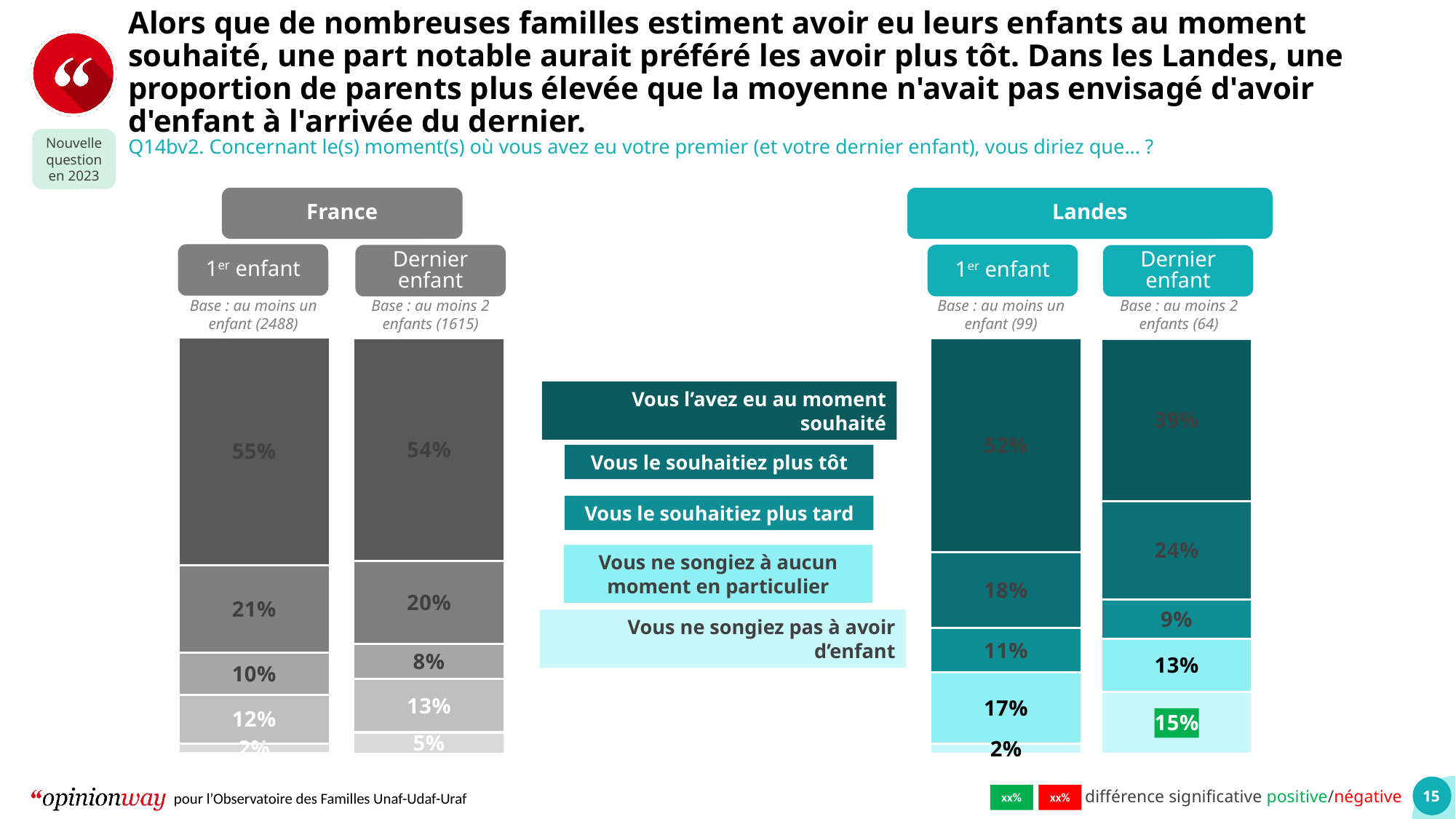
In the Landes chart, what is the value for "Vous le souhaitiez plus tôt" for the 1er enfant? 18% What is the base (number of respondents) for the Dernier enfant bar in the Landes chart? 64 What kind of chart is used on this slide? Stacked bar chart In the Landes chart, which segment of the Dernier enfant bar is highlighted in green as a significant positive difference, and what is its value? Vous ne songiez pas à avoir d'enfant, 15% What is the difference between the "Vous l'avez eu au moment souhaité" value for the 1er enfant in France (55%) and in the Landes (52%)? 3 points In the Landes chart, what percentage for the Dernier enfant corresponds to "Vous l'avez eu au moment souhaité"? 39% In the Landes chart, which response category has the highest value for the 1er enfant? Vous l'avez eu au moment souhaité In the France chart, what is the value for "Vous ne songiez pas à avoir d'enfant" for the Dernier enfant? 5% In the France chart, which response category has the lowest value for the 1er enfant? Vous ne songiez pas à avoir d'enfant In the France chart, what percentage of parents of a 1er enfant say they had the child at the moment they wished ("Vous l'avez eu au moment souhaité")? 55% How many response categories does the legend list? 5 Which is larger: the "Vous le souhaitiez plus tôt" value for the Dernier enfant in the Landes or in France? Landes (24%)